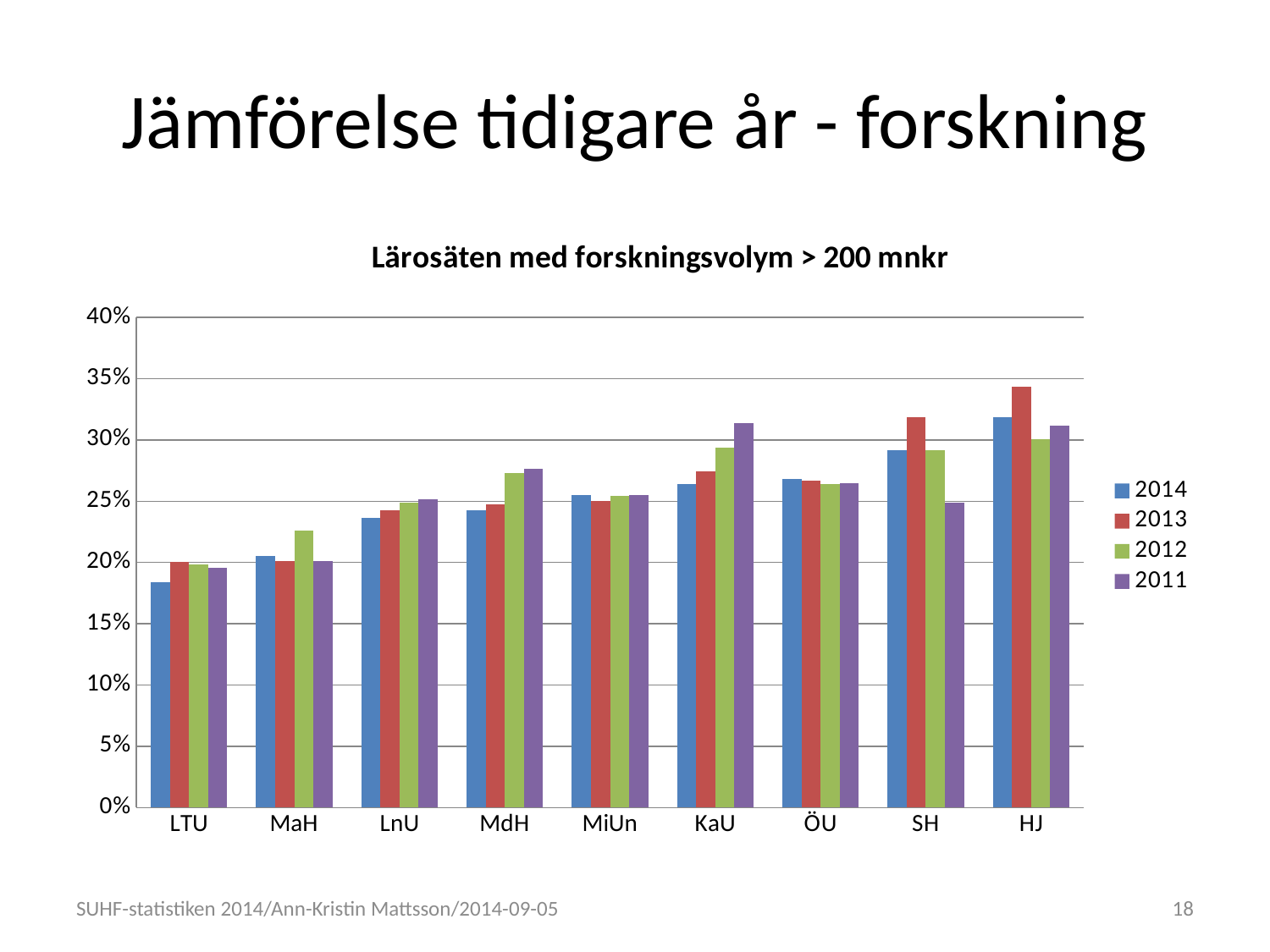
Is the 2013 value for HJ greater or less than 30%? greater For KaU, which is larger: the 2011 value or the 2014 value? 2011 Do the 2014 values generally rise or fall from LTU to HJ along the x axis? rise What is the title of the chart? Lärosäten med forskningsvolym > 200 mnkr How many series does the legend list? 4 What kind of chart is shown on the slide? bar chart For SH, which is larger: the 2013 value or the 2011 value? 2013 Which institution has the highest 2013 value? HJ Is the 2014 value for LTU greater or less than 20%? less Is the 2011 value for KaU greater or less than 30%? greater Which institution has the lowest 2014 value? LTU How many institutions (categories) are shown on the x axis? 9